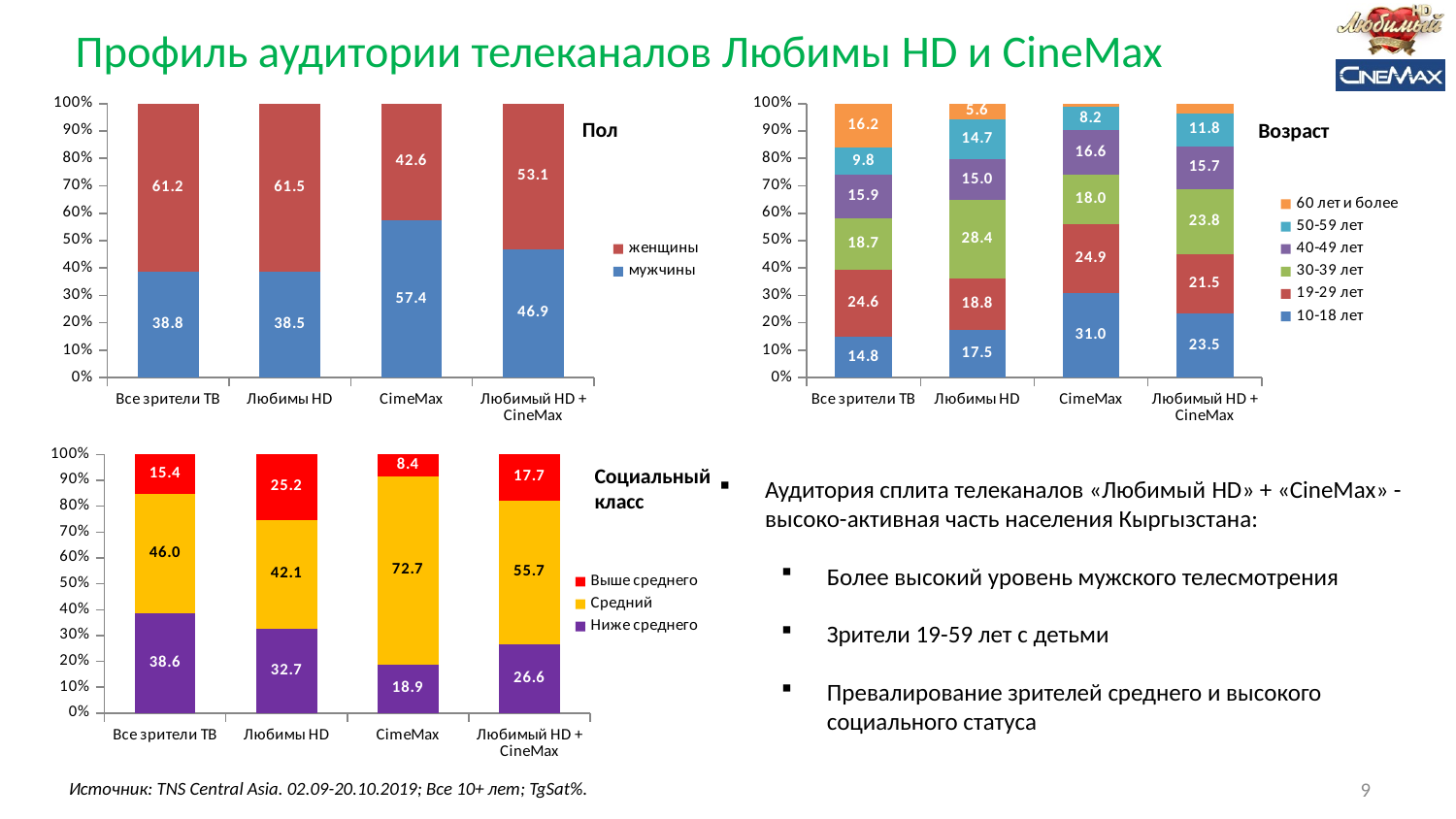
In the 'Социальный класс' chart, which category has the lowest value for Ниже среднего? CimeMax In the 'Социальный класс' chart, what is the difference between the Выше среднего values for Любимы HD and CimeMax? 16.8 In the 'Пол' chart, what is the difference between the женщины values for Все зрители ТВ and CimeMax? 18.6 How many series does the legend of the 'Пол' chart list? 2 What type of chart is the 'Социальный класс' chart? Stacked bar chart In the 'Возраст' chart, is the value for 60 лет и более larger for Все зрители ТВ or for Любимы HD? Все зрители ТВ In the 'Пол' chart, what is the value for мужчины for CimeMax? 57.4 In the 'Возраст' chart, what is the value for 30-39 лет for Любимы HD? 28.4 In the 'Социальный класс' chart, what is the value for Средний for CimeMax? 72.7 In the 'Возраст' chart, which category has the highest value for 10-18 лет? CimeMax In the 'Пол' chart, which category has the highest value for женщины? Любимы HD How many series does the legend of the 'Возраст' chart list? 6